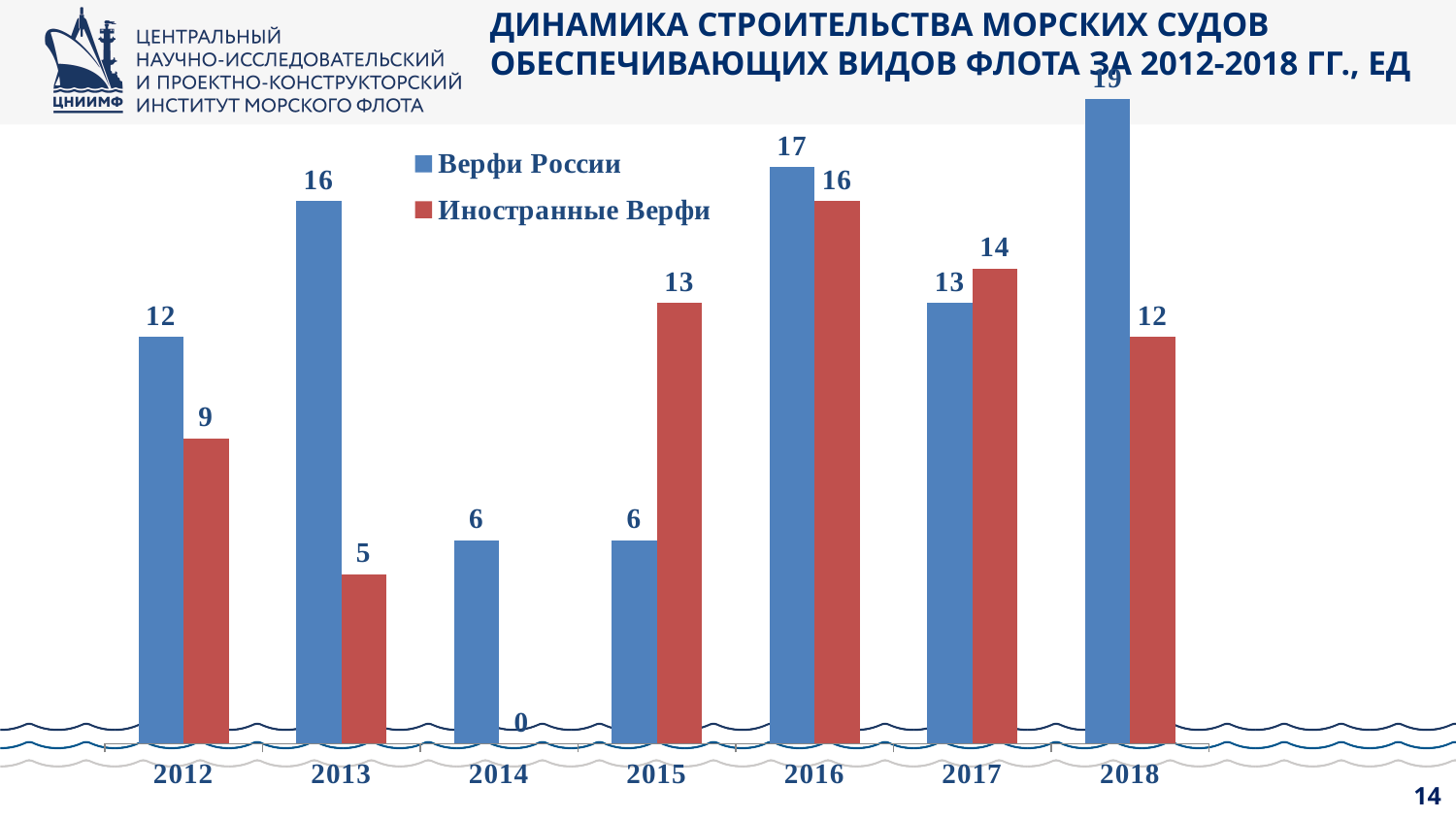
How many years are shown on the x axis? 7 Which series has the larger value in 2015, Верфи России or Иностранные Верфи? Иностранные Верфи Which colour represents Иностранные Верфи in the chart? red What type of chart is shown on the slide? bar chart In which year is the value for Иностранные Верфи lowest? 2014 What is the difference between Верфи России and Иностранные Верфи in 2013? 11 What is the value for Иностранные Верфи in 2014? 0 In which year is the value for Верфи России highest? 2018 What is the value for Иностранные Верфи in 2015? 13 How many series does the legend list? 2 What is the total of Верфи России and Иностранные Верфи in 2016? 33 What is the value for Верфи России in 2013? 16